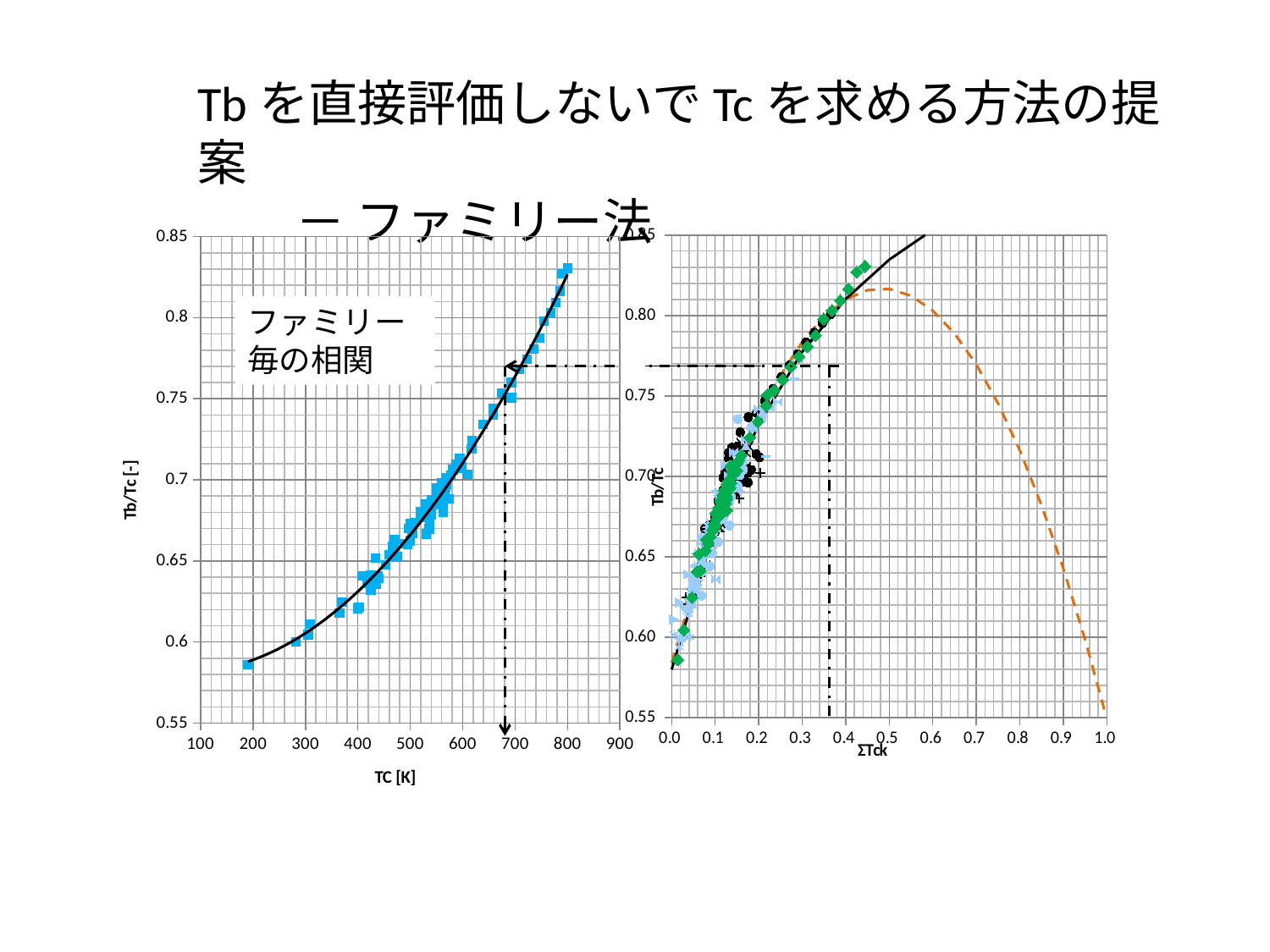
On the left chart, is the Tb/Tc value of the point at TC = 800 K greater or less than 0.8? greater On the left chart, is the Tb/Tc value of the point with the lowest TC (near 200 K) greater or less than 0.6? less What kind of chart is the left chart (Tb/Tc vs TC [K])? scatter chart On the right chart, is the Tb/Tc value of the highest green diamond point greater or less than 0.80? greater On the right chart, do the plotted Tb/Tc points rise or fall as ΣTck increases from 0.0 to 0.4? rise On the left chart, do the Tb/Tc values rise or fall as TC increases? rise On the right chart, what is the label of the x axis? ΣTck On the right chart, does the orange dashed curve rise or fall as ΣTck increases from 0.6 to 1.0? fall On the left chart, what is the label of the x axis? TC [K] What kind of chart is the right chart (Tb/Tc vs ΣTck)? scatter chart On the right chart, what is the maximum value shown on the x axis? 1.0